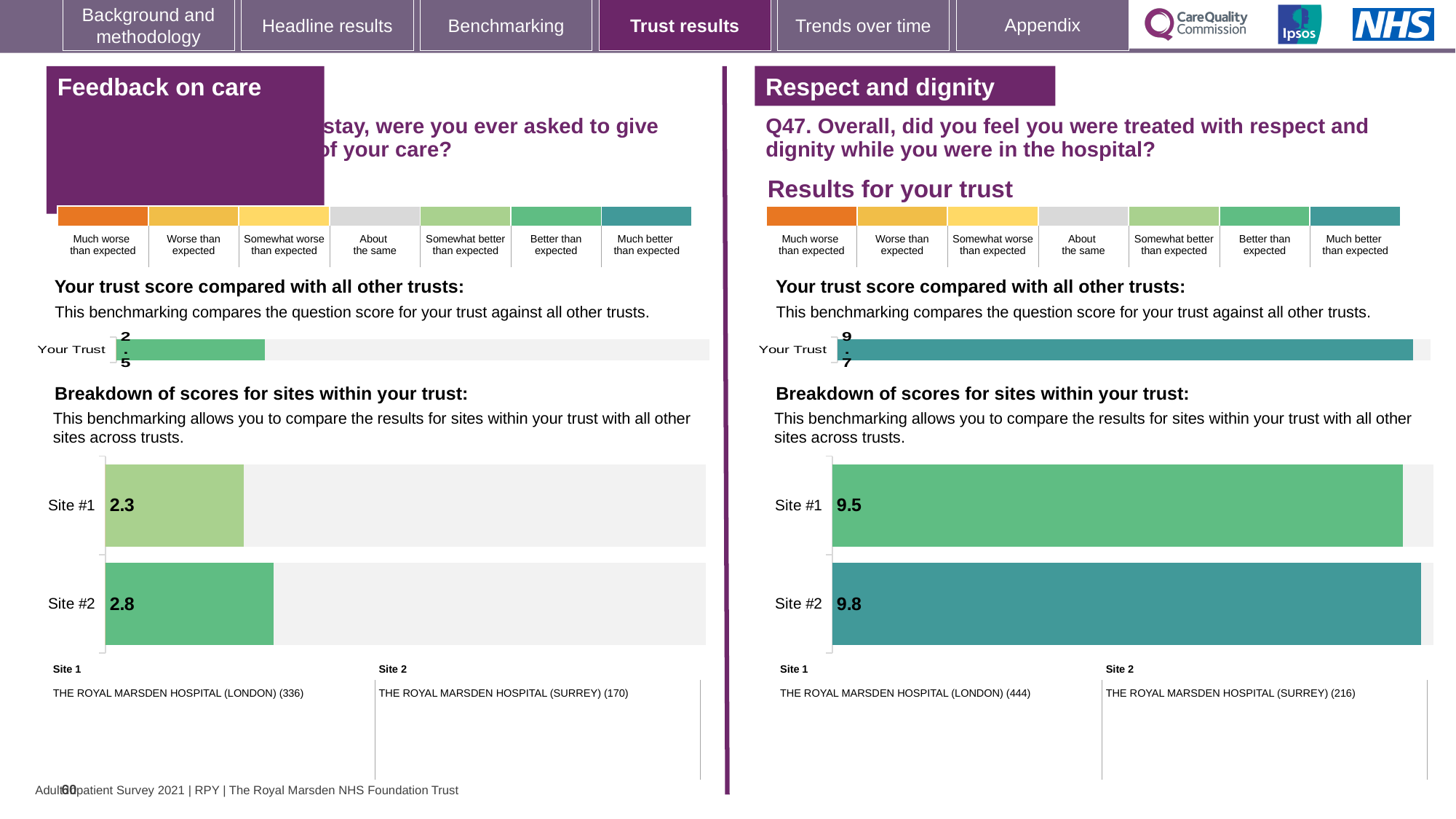
In the 'Respect and dignity' trust score chart, what is the score for Your Trust? 9.7 In the 'Respect and dignity' site breakdown chart, what is the score for Site #2? 9.8 In the 'Feedback on care' site breakdown chart, what is the score for Site #2? 2.8 In the 'Respect and dignity' site breakdown chart, which site has the lower score? Site #1 In the 'Feedback on care' site breakdown chart, what is the difference between the Site #2 and Site #1 scores? 0.5 In the 'Respect and dignity' site breakdown chart, what is the difference between the Site #2 and Site #1 scores? 0.3 What type of chart is used for the site breakdown in the 'Feedback on care' section? Bar chart In the 'Feedback on care' trust score chart, what is the score for Your Trust? 2.5 In the 'Feedback on care' site breakdown chart, what is the score for Site #1? 2.3 In the 'Respect and dignity' site breakdown chart, what is the score for Site #1? 9.5 How many sites are shown in the 'Respect and dignity' site breakdown chart? 2 In the 'Feedback on care' site breakdown chart, which site has the higher score? Site #2